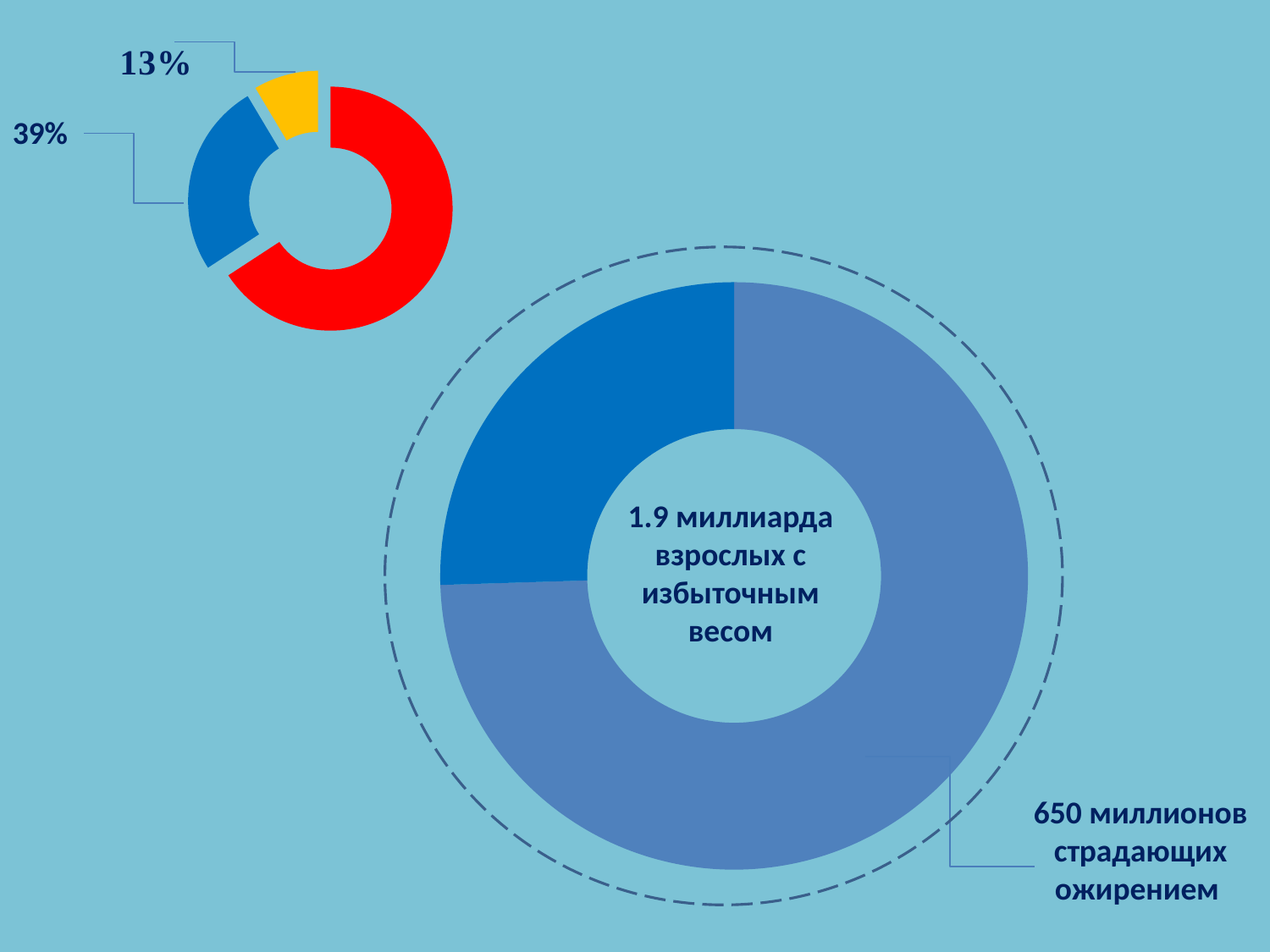
In the small donut chart at the top left, which colour slice is the largest? Red In the small donut chart at the top left, what value is shown for the blue slice? 39% What text is written in the centre of the large donut chart on the right? 1.9 миллиарда взрослых с избыточным весом What type of chart is the small chart at the top left of the slide? Donut (pie) chart In the large donut chart on the right, which slice is larger: the lighter blue slice or the darker blue slice? The lighter blue slice In the small donut chart at the top left, which colour slice is the smallest? Yellow In the small donut chart at the top left, what value is shown for the yellow slice? 13% What label is attached to the lighter blue slice of the large donut chart on the right? 650 миллионов страдающих ожирением How many slices does the large donut chart on the right have? 2 How many slices does the small donut chart at the top left have? 3 In the small donut chart at the top left, which is larger: the blue slice or the yellow slice? The blue slice In the small donut chart at the top left, what is the difference between the blue slice (39%) and the yellow slice (13%)? 26%